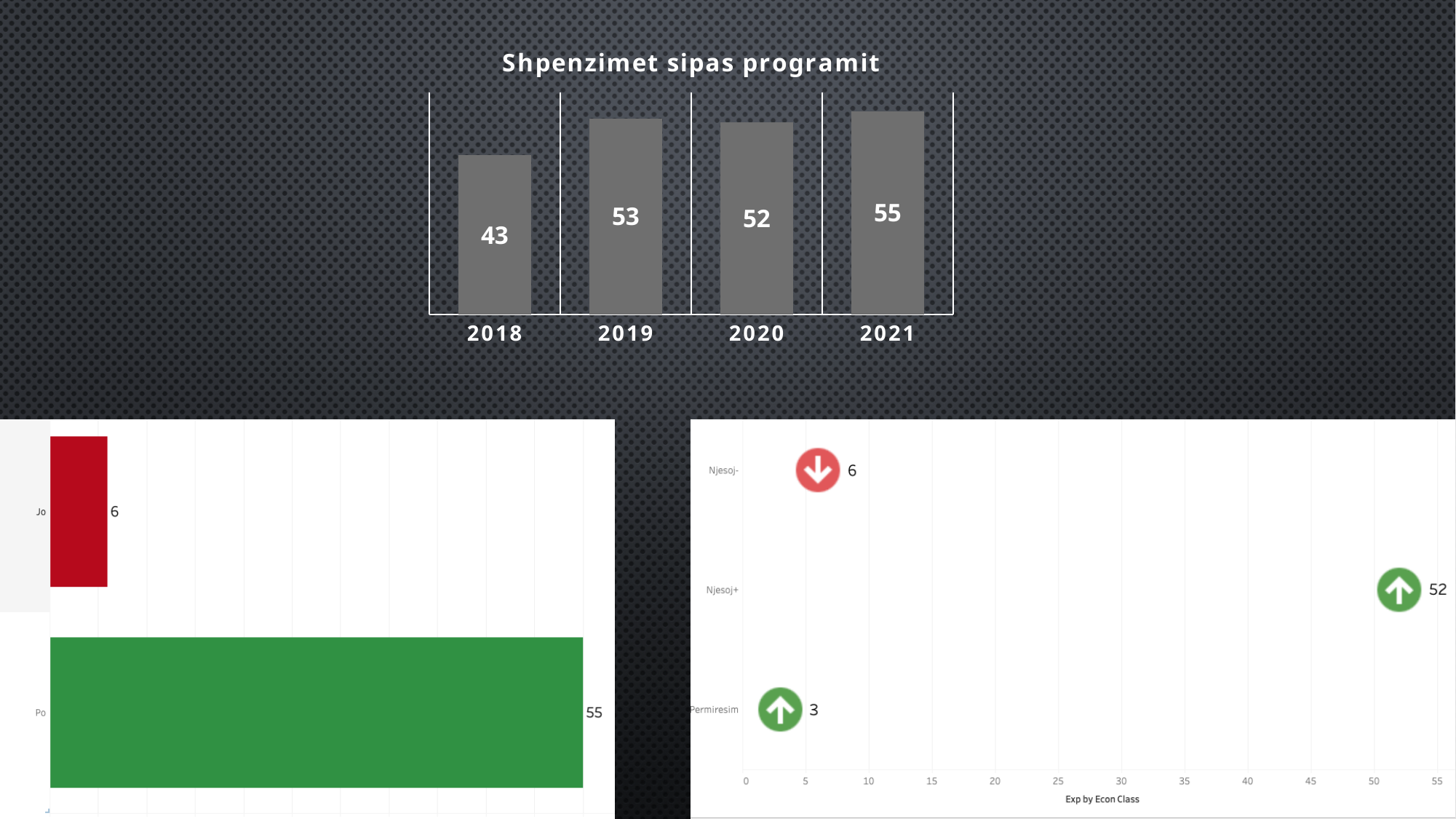
In the chart titled "Shpenzimet sipas programit", how many years are shown on the x axis? 4 In the bottom-right chart, what is the value for Njesoj+? 52 In the bottom-left chart, what is the difference between the values for Po and Jo? 49 In the bottom-left chart, what is the value for Po? 55 In the bottom-left chart, which category is larger, Jo or Po? Po What kind of chart is the chart titled "Shpenzimet sipas programit"? bar chart In the chart titled "Shpenzimet sipas programit", what is the value for 2020? 52 In the chart titled "Shpenzimet sipas programit", what is the value for 2018? 43 In the bottom-right chart, what is the label of the x axis? Exp by Econ Class In the chart titled "Shpenzimet sipas programit", what is the difference between the values for 2021 and 2018? 12 In the chart titled "Shpenzimet sipas programit", which year has the highest value? 2021 In the chart titled "Shpenzimet sipas programit", which year has the lowest value? 2018